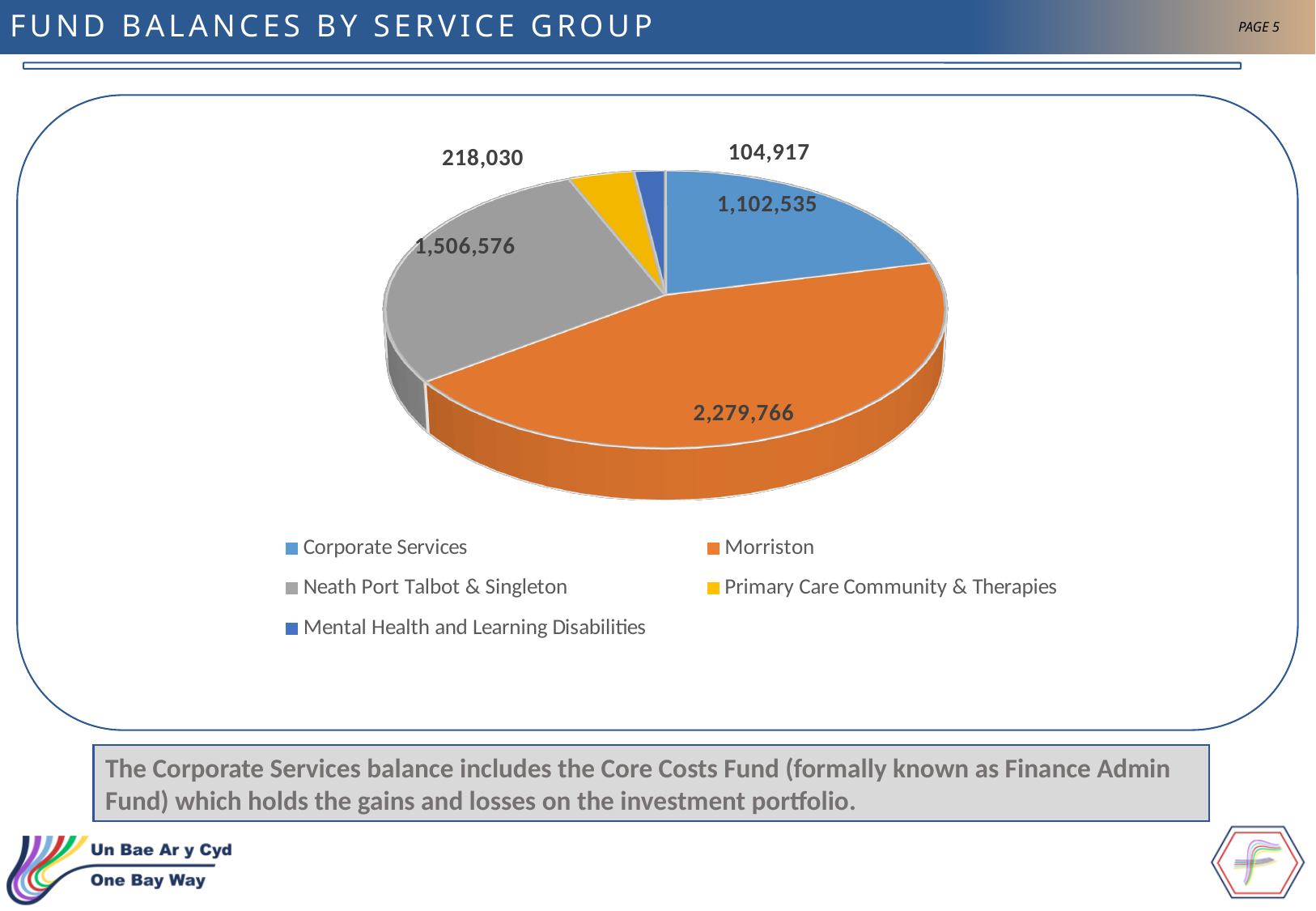
What is the fund balance for Neath Port Talbot & Singleton? 1,506,576 What is the difference between the fund balances of Primary Care Community & Therapies and Mental Health and Learning Disabilities? 113,113 How many service groups are shown in the pie chart? 5 What is the fund balance for Mental Health and Learning Disabilities? 104,917 What type of chart is shown on the slide? Pie chart What is the fund balance for Corporate Services? 1,102,535 What is the fund balance for Morriston? 2,279,766 Which service group has the smallest fund balance? Mental Health and Learning Disabilities What is the difference between the fund balances of Morriston and Neath Port Talbot & Singleton? 773,190 Which has a larger fund balance, Corporate Services or Neath Port Talbot & Singleton? Neath Port Talbot & Singleton Which service group has the largest fund balance? Morriston What is the fund balance for Primary Care Community & Therapies? 218,030